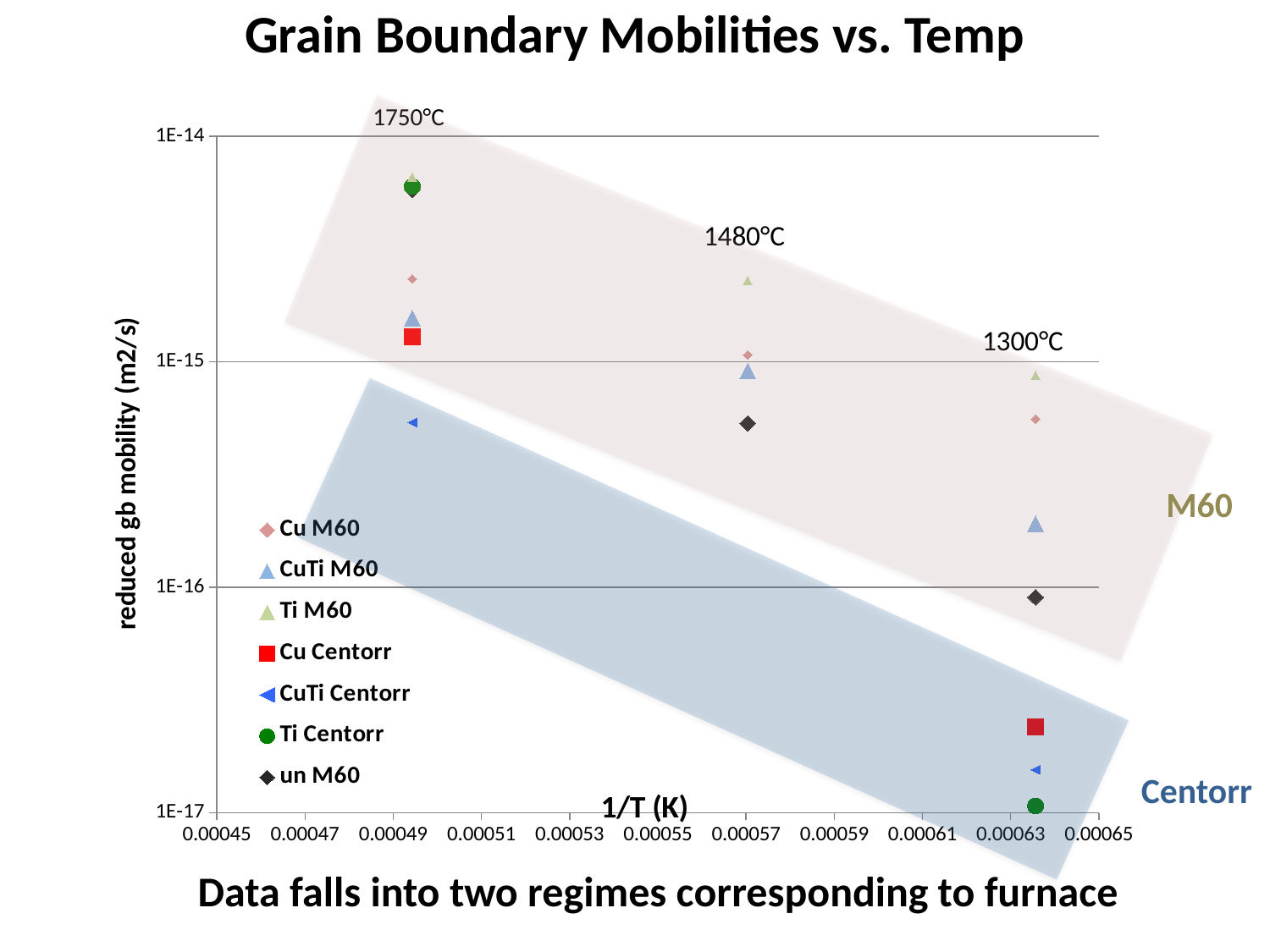
How many temperature values are annotated on the chart? 3 Which series has the lowest plotted value on the chart? Ti Centorr Which is larger for Ti Centorr: the value at 1750°C or the value at 1300°C? 1750°C Is the value for Ti Centorr at 1300°C greater or less than 1E-16? less What is the label of the y axis? reduced gb mobility (m2/s) How many series does the legend list? 7 What kind of chart is shown on the slide? scatter chart Is the value for Ti M60 at 1750°C greater or less than 1E-14? less Is the value for Cu Centorr at 1750°C greater or less than 1E-15? greater What is the title of the chart? Grain Boundary Mobilities vs. Temp Do the plotted mobility values rise or fall as 1/T increases along the x axis? fall